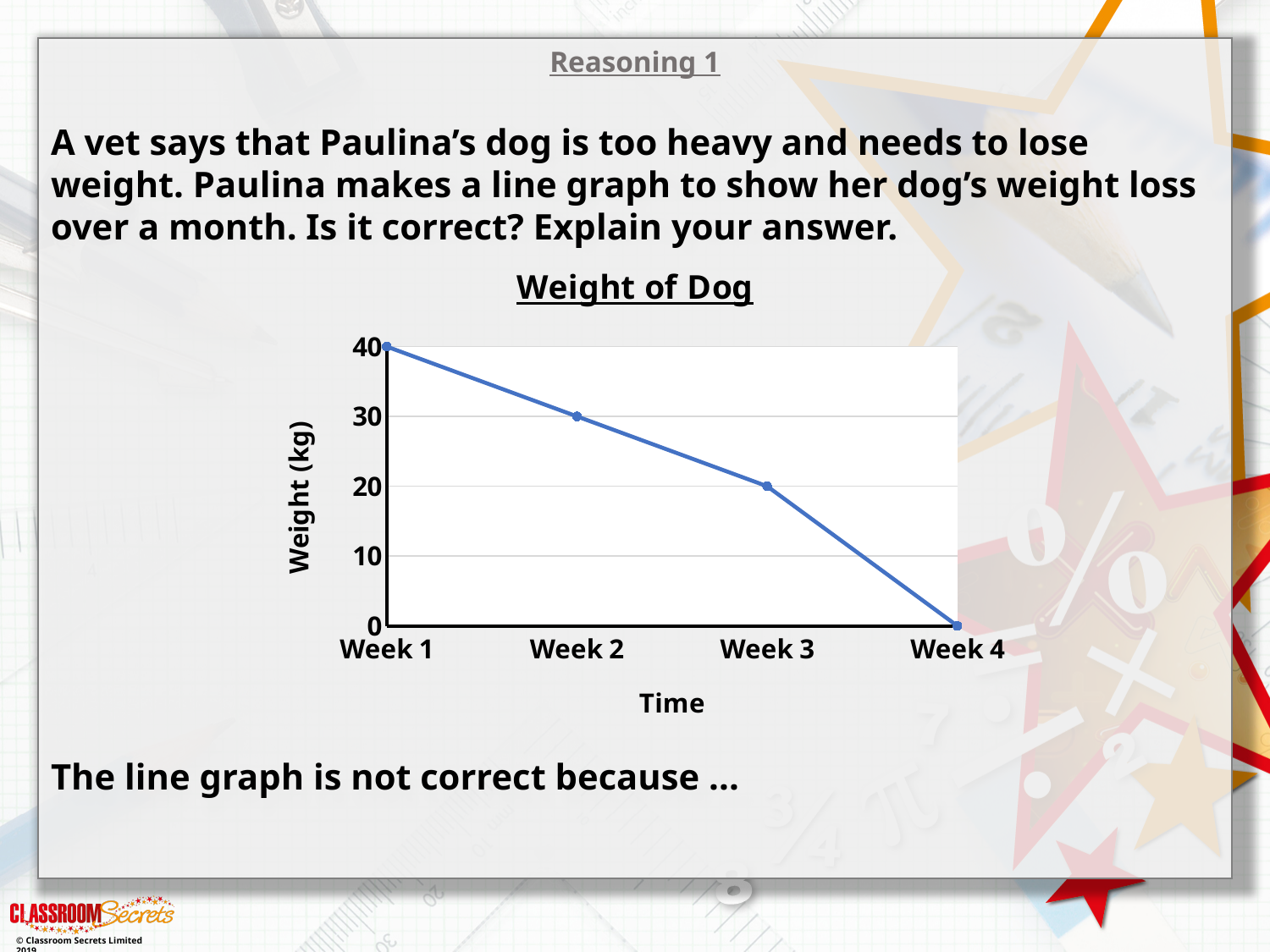
What is the dog's weight in Week 3? 20 What is the dog's weight in Week 4? 0 What kind of chart is shown on the slide? line chart What is the title of the chart? Weight of Dog What is the difference in weight between Week 1 and Week 3? 20 What is the dog's weight in Week 1? 40 In which week is the dog's weight highest? Week 1 What is the dog's weight in Week 2? 30 How many weeks are plotted on the x axis? 4 Which is larger, the weight in Week 2 or the weight in Week 3? Week 2 In which week is the dog's weight lowest? Week 4 Does the dog's weight rise or fall from Week 1 to Week 4? fall